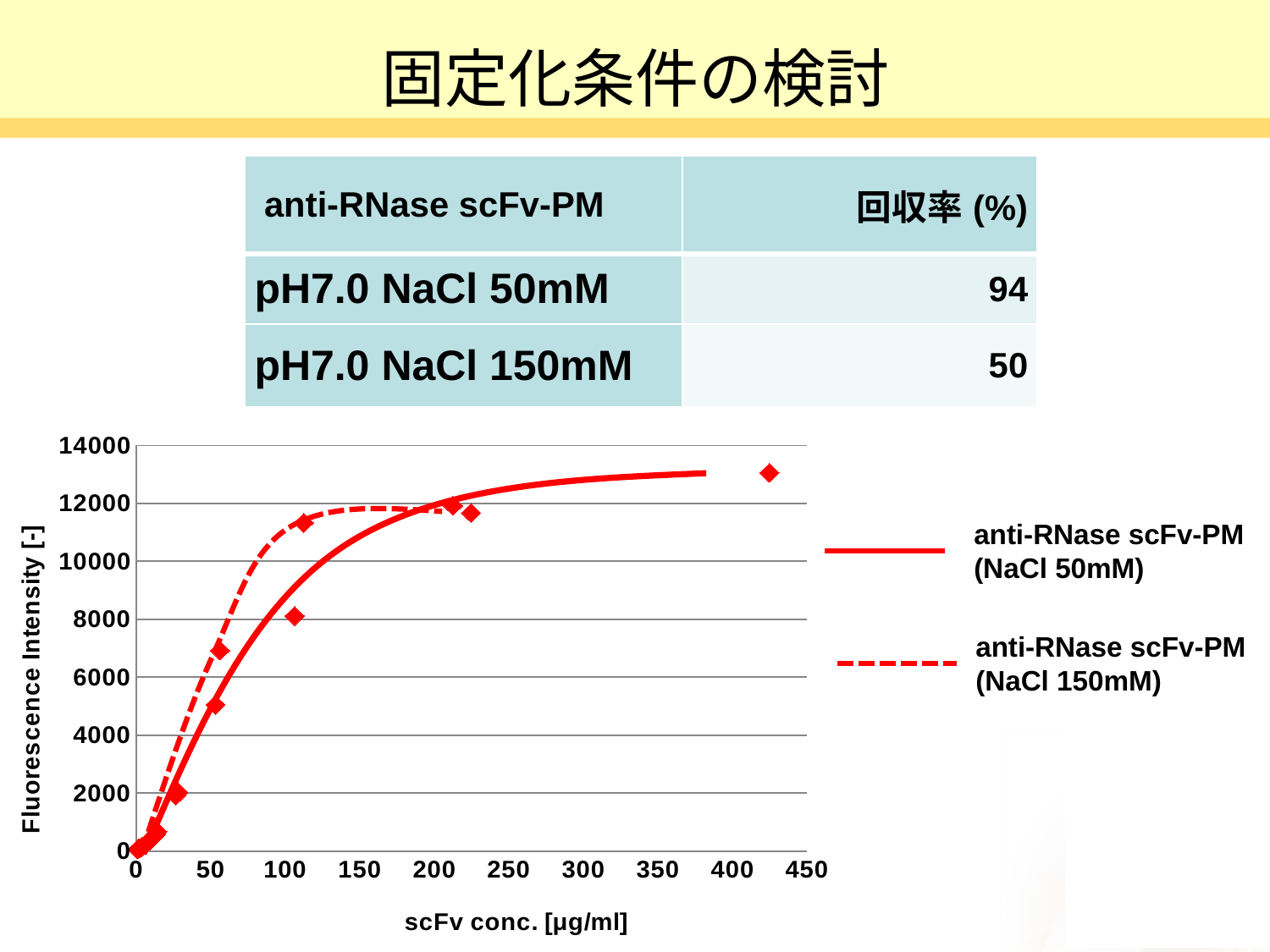
What is the label of the y axis of the chart? Fluorescence Intensity [-] What is the highest value shown on the y axis of the chart? 14000 Do the fluorescence intensity values rise or fall as scFv concentration increases along the x axis? rise Which series is drawn with a dashed line in the chart? anti-RNase scFv-PM (NaCl 150mM) At an scFv concentration of about 100 μg/ml, which series shows the higher fluorescence intensity, NaCl 50mM or NaCl 150mM? NaCl 150mM What kind of chart is shown on the slide? scatter chart Is the fluorescence intensity of the anti-RNase scFv-PM (NaCl 150mM) series at about 100 μg/ml greater or less than 10000? greater How many series does the chart legend list? 2 Is the fluorescence intensity of the anti-RNase scFv-PM (NaCl 50mM) series at 400 μg/ml greater or less than 12000? greater Is the fluorescence intensity of the anti-RNase scFv-PM (NaCl 50mM) series at about 50 μg/ml greater or less than 6000? less What is the label of the x axis of the chart? scFv conc. [μg/ml]